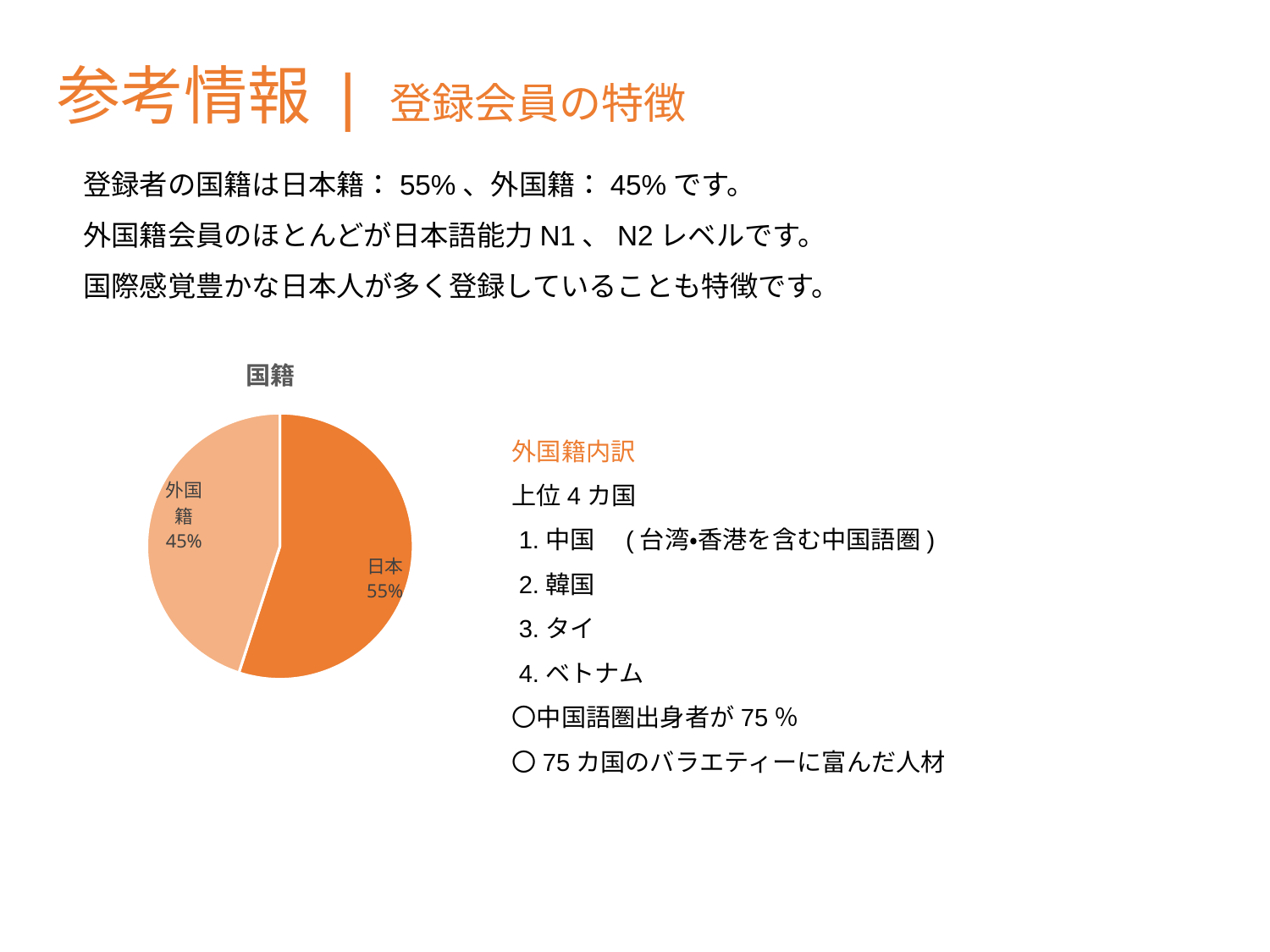
What is the title of the pie chart? 国籍 Is the value for 外国籍 greater or less than 50%? less Which is larger, the 日本 slice or the 外国籍 slice? 日本 How many slices does the pie chart have? 2 What share of the pie does 外国籍 represent? 45% Which slice of the pie chart is the largest? 日本 What is the difference in percentage points between the 日本 slice and the 外国籍 slice? 10 percentage points What share of the pie does 日本 represent? 55% Is the value for 日本 greater or less than 50%? greater What kind of chart is shown on the slide? pie chart Which slice of the pie chart is the smallest? 外国籍 Which slice of the pie chart is drawn in the darker orange colour? 日本